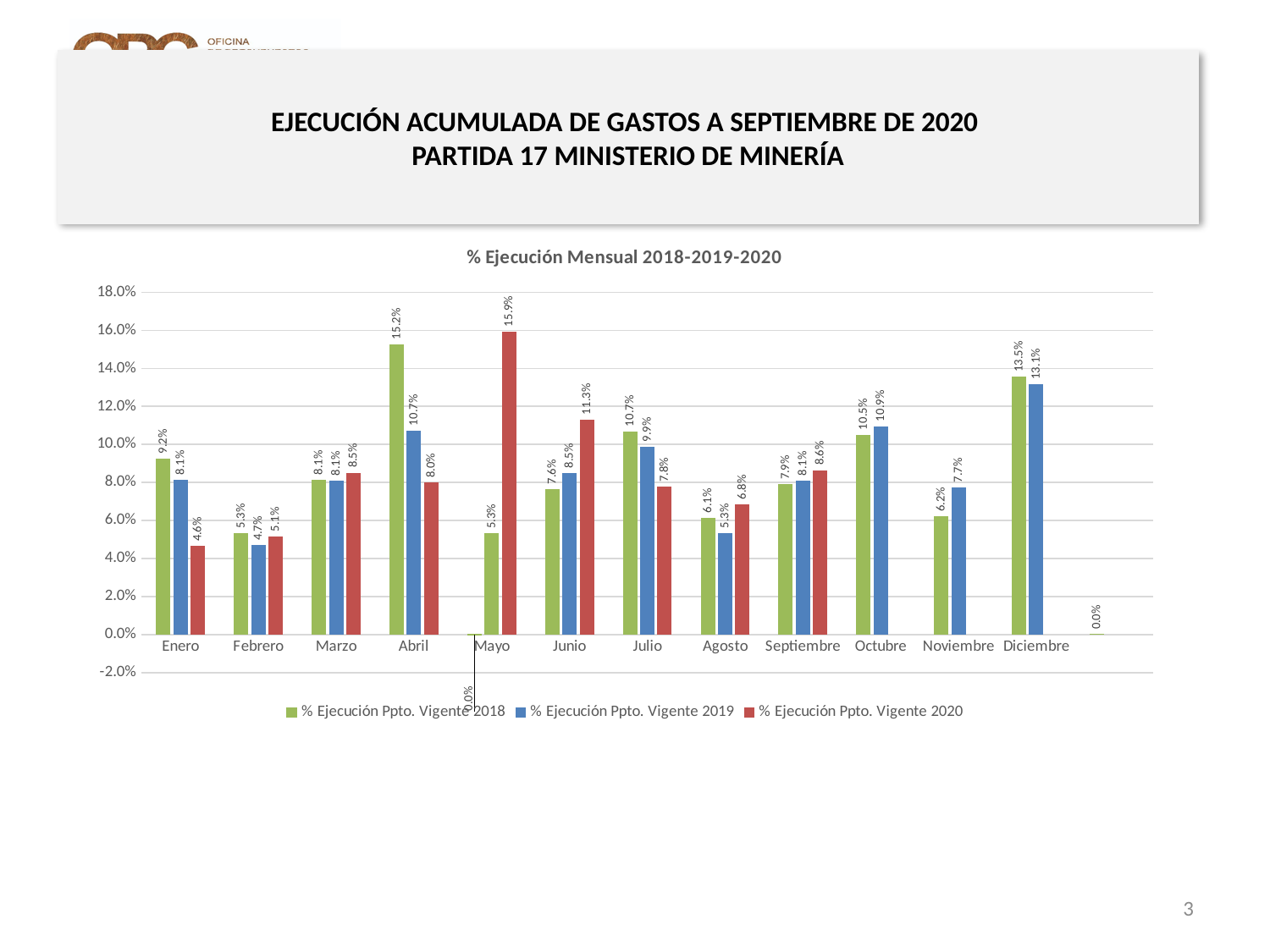
What kind of chart is shown on the slide? Bar chart Which month has the highest value in the % Ejecución Ppto. Vigente 2020 series? Mayo What is the title of the chart? % Ejecución Mensual 2018-2019-2020 How many series does the legend list? 3 Is the value for Diciembre in the % Ejecución Ppto. Vigente 2018 series greater or less than 12.0%? greater How many months are shown on the x axis? 12 Which month has the lowest value in the % Ejecución Ppto. Vigente 2018 series? Mayo What is the value for Octubre in the % Ejecución Ppto. Vigente 2019 series? 10.9% Which is larger for Junio: the 2019 value or the 2020 value? 2020 What is the value for Mayo in the % Ejecución Ppto. Vigente 2020 series? 15.9% What is the value for Abril in the % Ejecución Ppto. Vigente 2018 series? 15.2% What is the difference between the 2018 and 2020 values for Enero? 4.6%